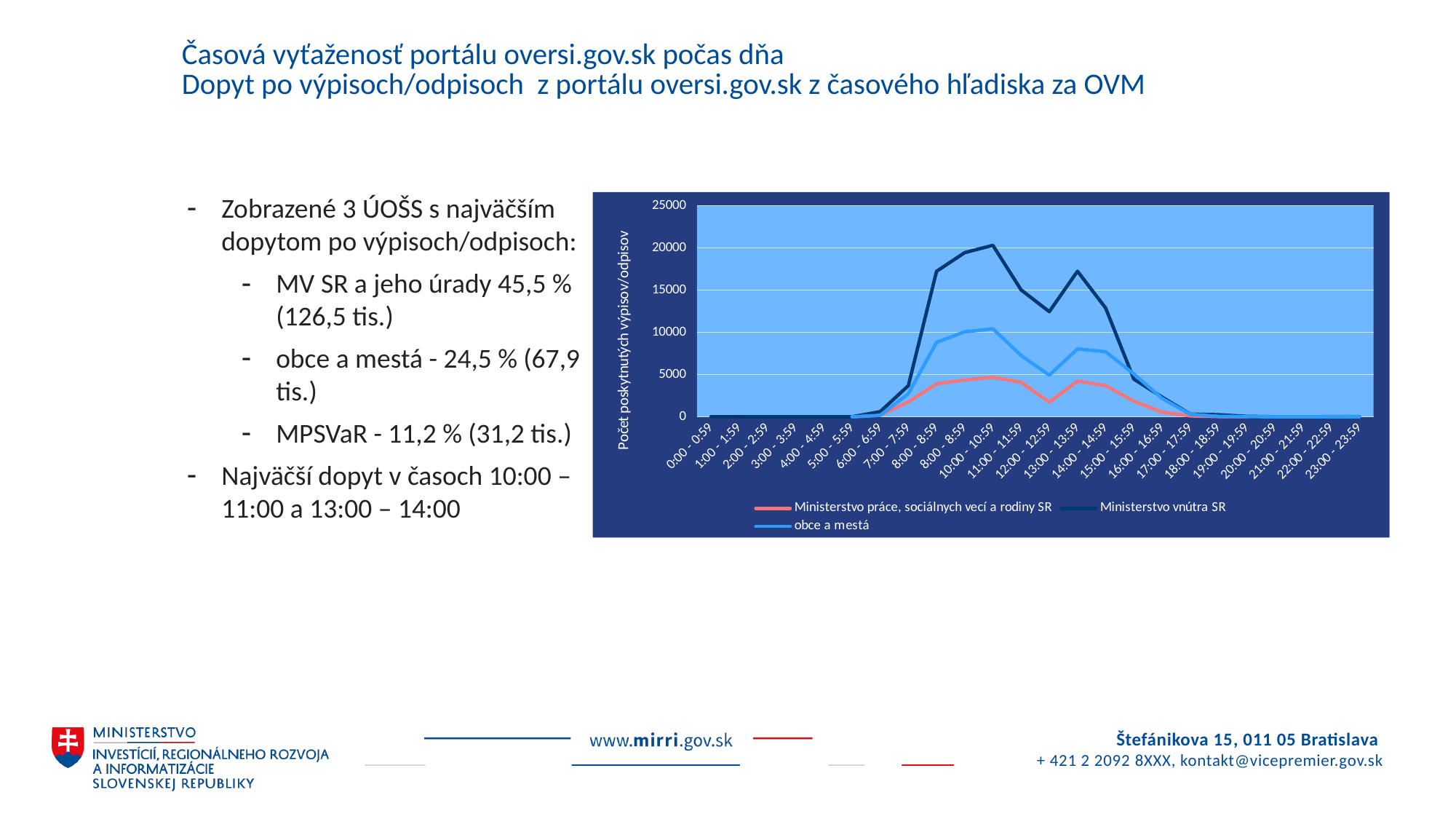
How many series does the chart legend list? 3 Is the value for obce a mestá in the 10:00 - 10:59 interval greater or less than 5000? greater In the 10:00 - 10:59 interval, which series has the larger value: Ministerstvo vnútra SR or obce a mestá? Ministerstvo vnútra SR Is the value for Ministerstvo práce, sociálnych vecí a rodiny SR in the 10:00 - 10:59 interval greater or less than 10000? less Is the value for Ministerstvo vnútra SR in the 10:00 - 10:59 interval greater or less than 15000? greater What is the label of the chart's vertical axis? Počet poskytnutých výpisov/odpisov What kind of chart is shown on the slide? line chart In which hourly interval does the Ministerstvo vnútra SR series reach its peak? 10:00 - 10:59 Does the Ministerstvo vnútra SR series rise or fall from the 10:00 - 10:59 interval to the 12:00 - 12:59 interval? fall Which series reaches the highest value in the chart? Ministerstvo vnútra SR How many hourly intervals are shown on the x axis of the chart? 24